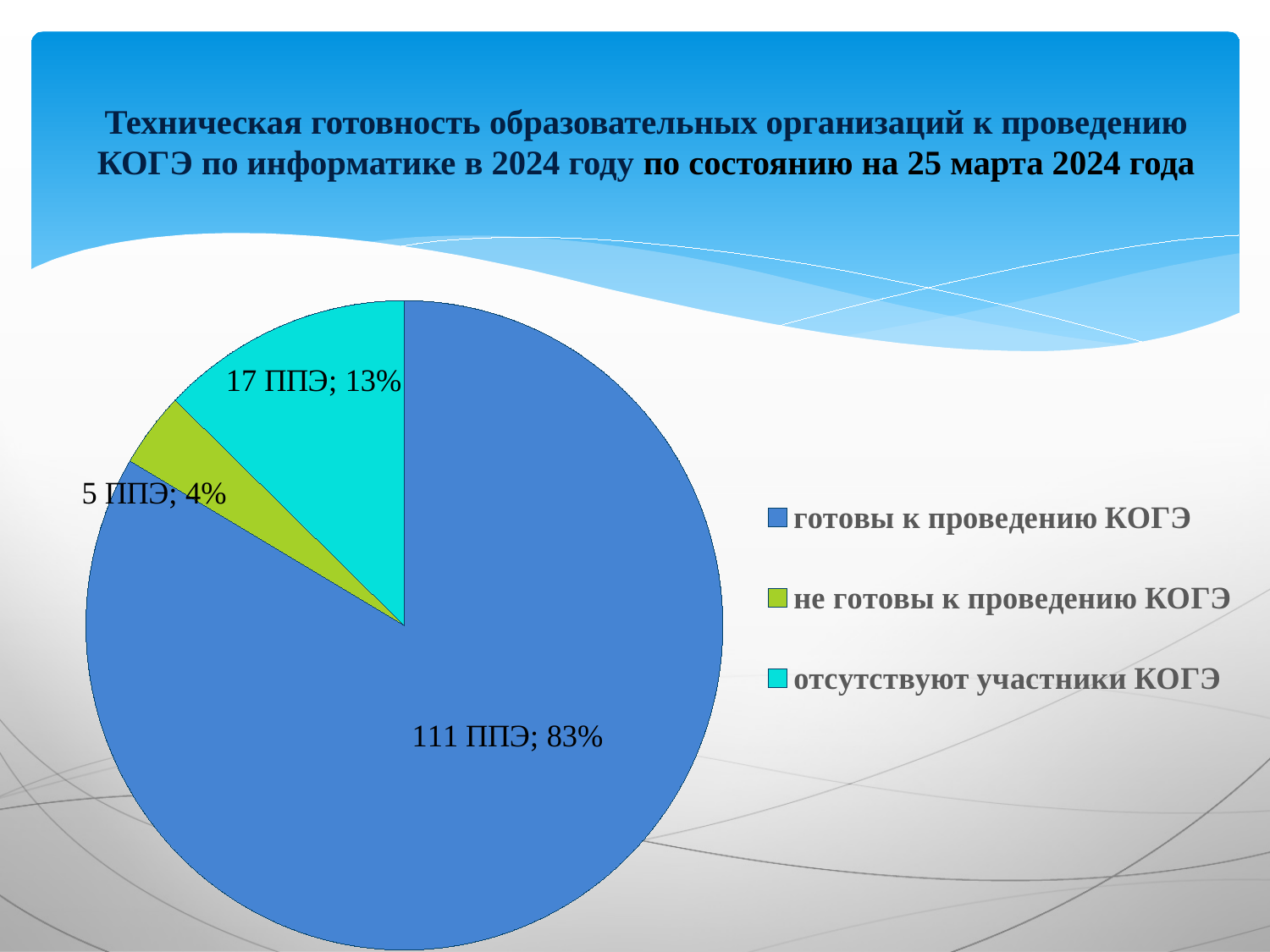
How many ППЭ are shown for 'отсутствуют участники КОГЭ'? 17 ППЭ What share of the pie does 'готовы к проведению КОГЭ' take? 83% What share of the pie does 'отсутствуют участники КОГЭ' take? 13% Which colour represents 'не готовы к проведению КОГЭ' in the legend? green Which category has the largest slice? готовы к проведению КОГЭ How many slices does the pie chart have? 3 What kind of chart is shown on the slide? pie chart How many ППЭ are shown for 'готовы к проведению КОГЭ'? 111 ППЭ What is the difference in ППЭ between 'отсутствуют участники КОГЭ' and 'не готовы к проведению КОГЭ'? 12 ППЭ Which category has the smallest slice? не готовы к проведению КОГЭ How many ППЭ are shown for 'не готовы к проведению КОГЭ'? 5 ППЭ How many entries does the legend list? 3